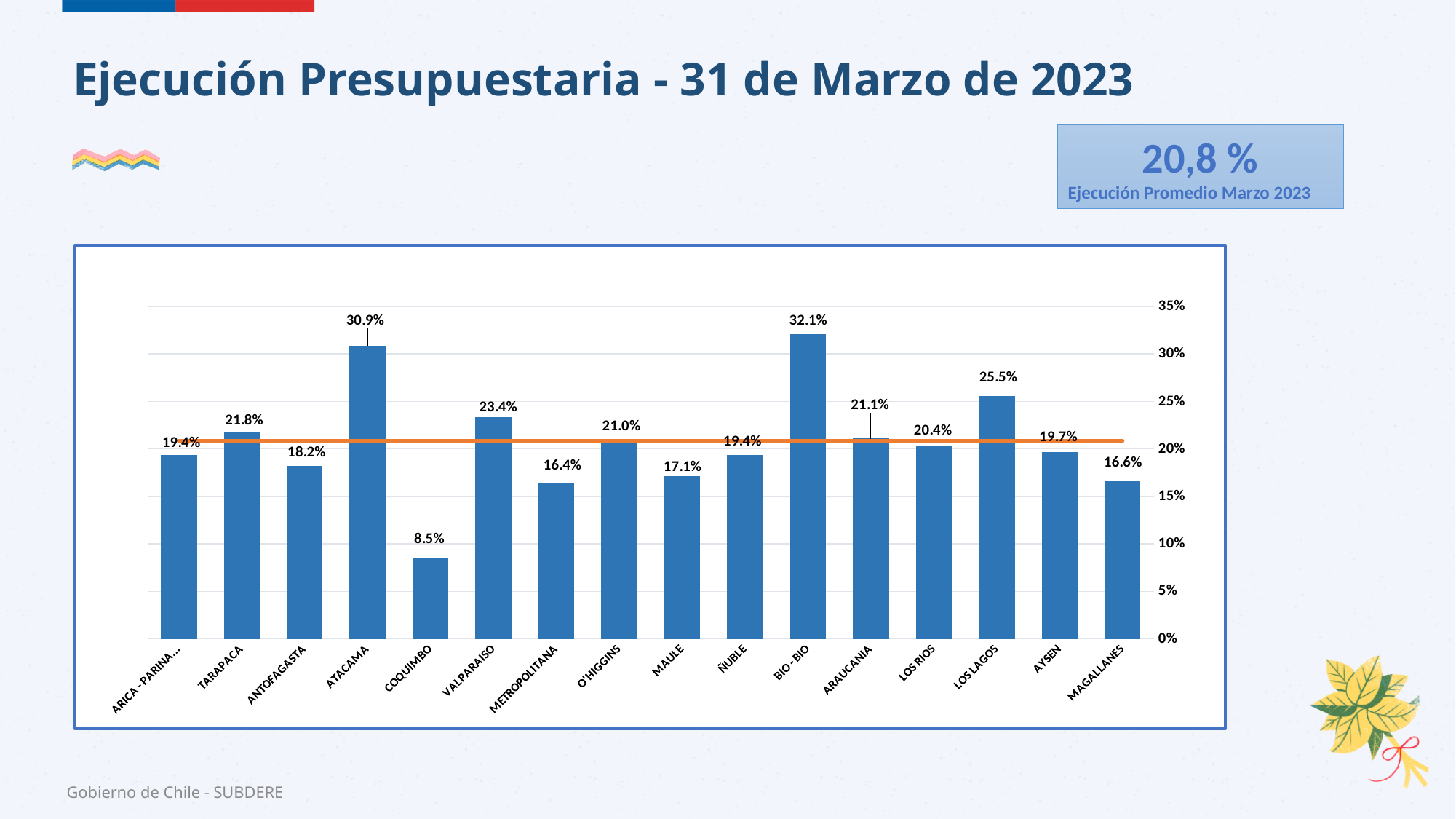
What is the difference between the values for BIO - BIO and ATACAMA? 1.2% What is the value for ATACAMA? 30.9% How many regions are shown on the x axis? 16 Which region has the lowest value? COQUIMBO Which region has the highest value? BIO - BIO What is the value for METROPOLITANA? 16.4% Which is larger, the value for VALPARAISO or the value for TARAPACA? VALPARAISO What value does the box labelled 'Ejecución Promedio Marzo 2023' show? 20,8 % What kind of chart is shown on the slide? bar chart What is the value for COQUIMBO? 8.5% What is the value for LOS LAGOS? 25.5% Is the value for MAULE greater or less than 20%? less